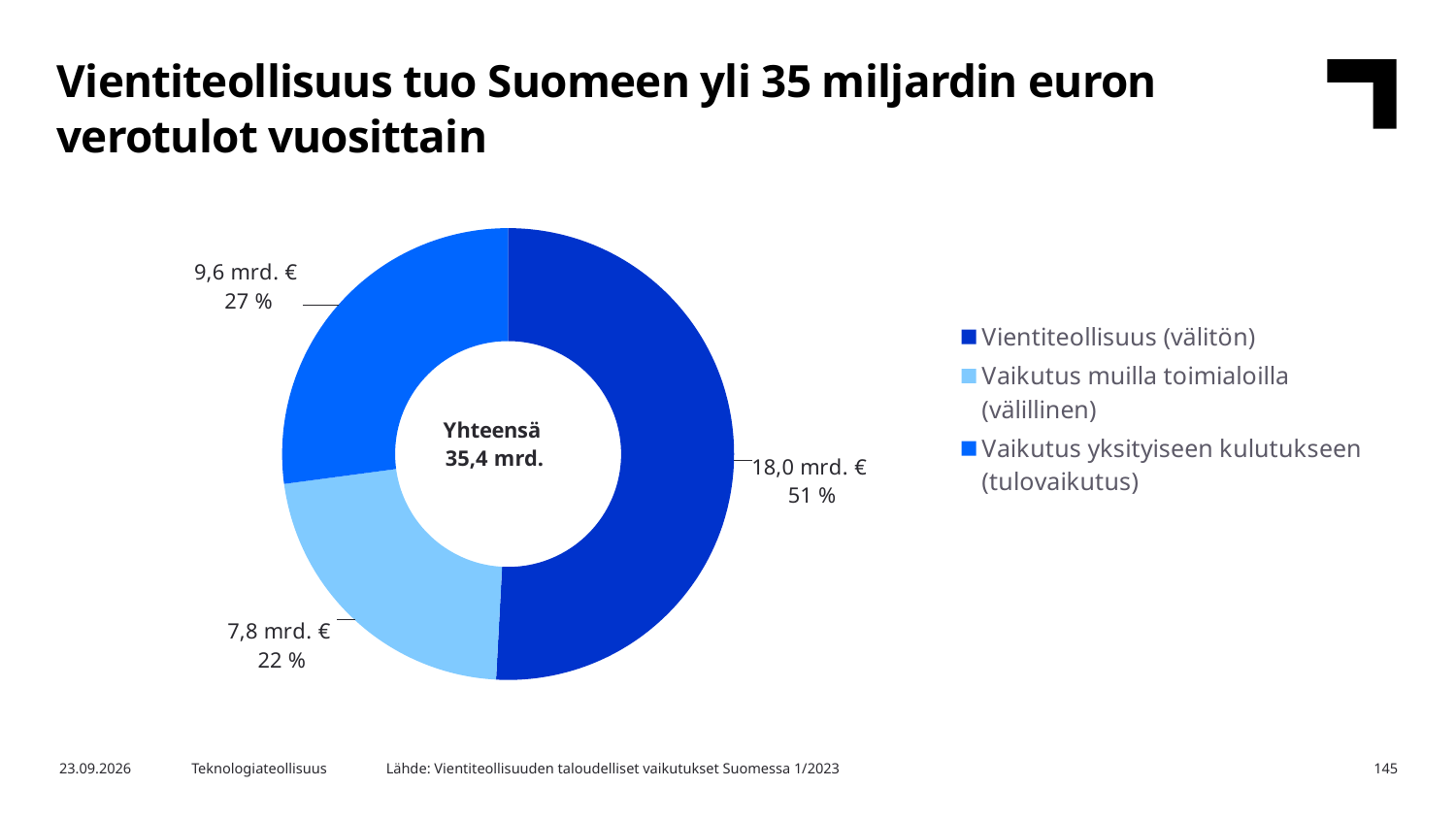
What total is shown in the centre of the donut chart? 35,4 mrd. What value is shown for Vientiteollisuus (välitön)? 18,0 mrd. € What is the difference between the values for Vientiteollisuus (välitön) and Vaikutus yksityiseen kulutukseen (tulovaikutus)? 8,4 mrd. € What value is shown for Vaikutus yksityiseen kulutukseen (tulovaikutus)? 9,6 mrd. € What share of the total does Vientiteollisuus (välitön) represent? 51 % Which category has the smallest slice? Vaikutus muilla toimialoilla (välillinen) How many entries does the legend list? 3 What value is shown for Vaikutus muilla toimialoilla (välillinen)? 7,8 mrd. € What share of the total does Vaikutus yksityiseen kulutukseen (tulovaikutus) represent? 27 % What kind of chart is shown on the slide? Donut (pie) chart Which category has the largest slice? Vientiteollisuus (välitön) What share of the total does Vaikutus muilla toimialoilla (välillinen) represent? 22 %